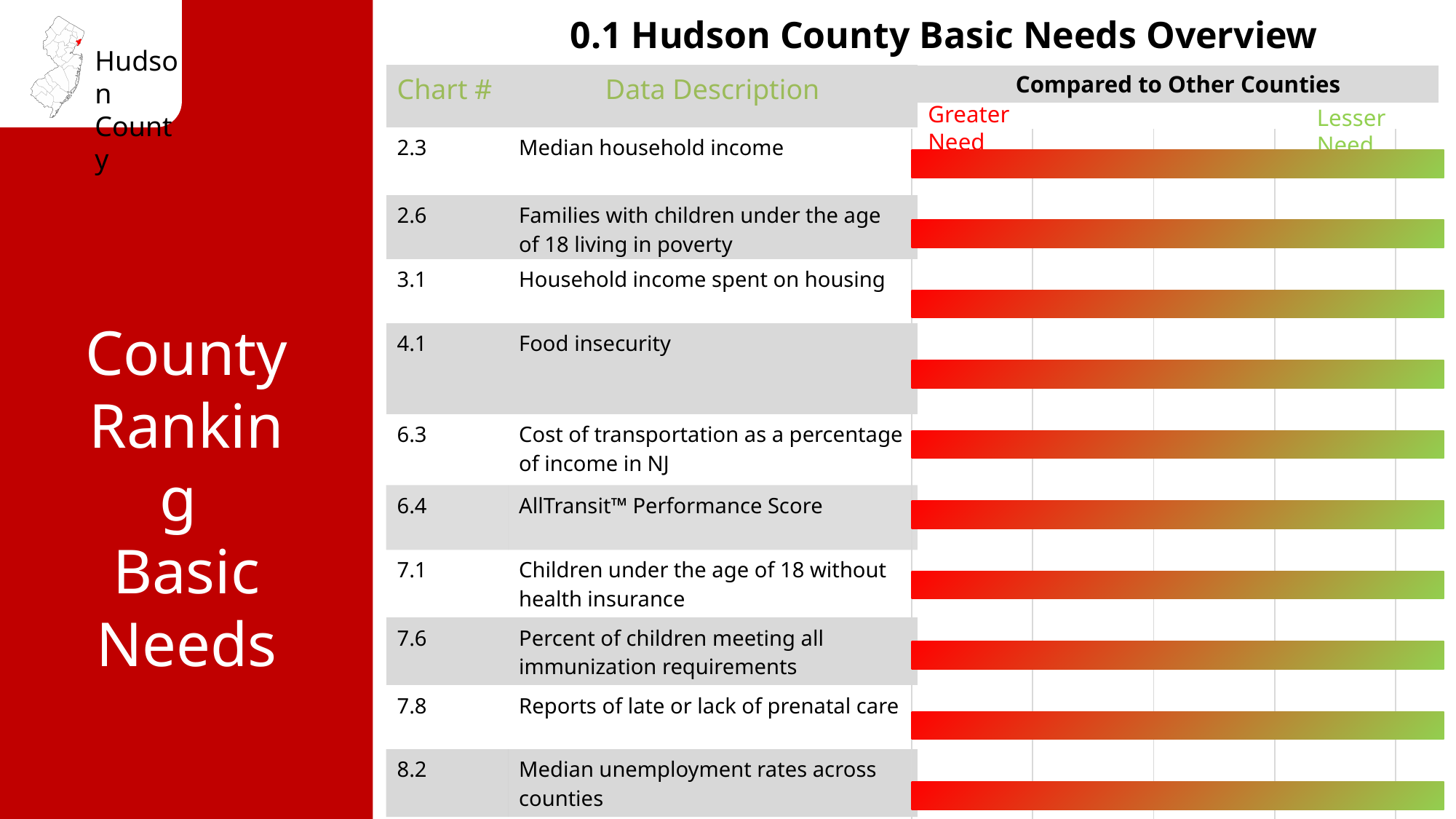
Which chart number is listed for the bar labelled 'Food insecurity'? 4.1 What is the title of the chart on the slide? 0.1 Hudson County Basic Needs Overview What label appears at the left end of the chart's scale, above the bars? Greater Need How many bars (data descriptions) are plotted in the chart? 10 What kind of chart is shown on the slide? bar chart Which data description corresponds to chart number 7.8? Reports of late or lack of prenatal care